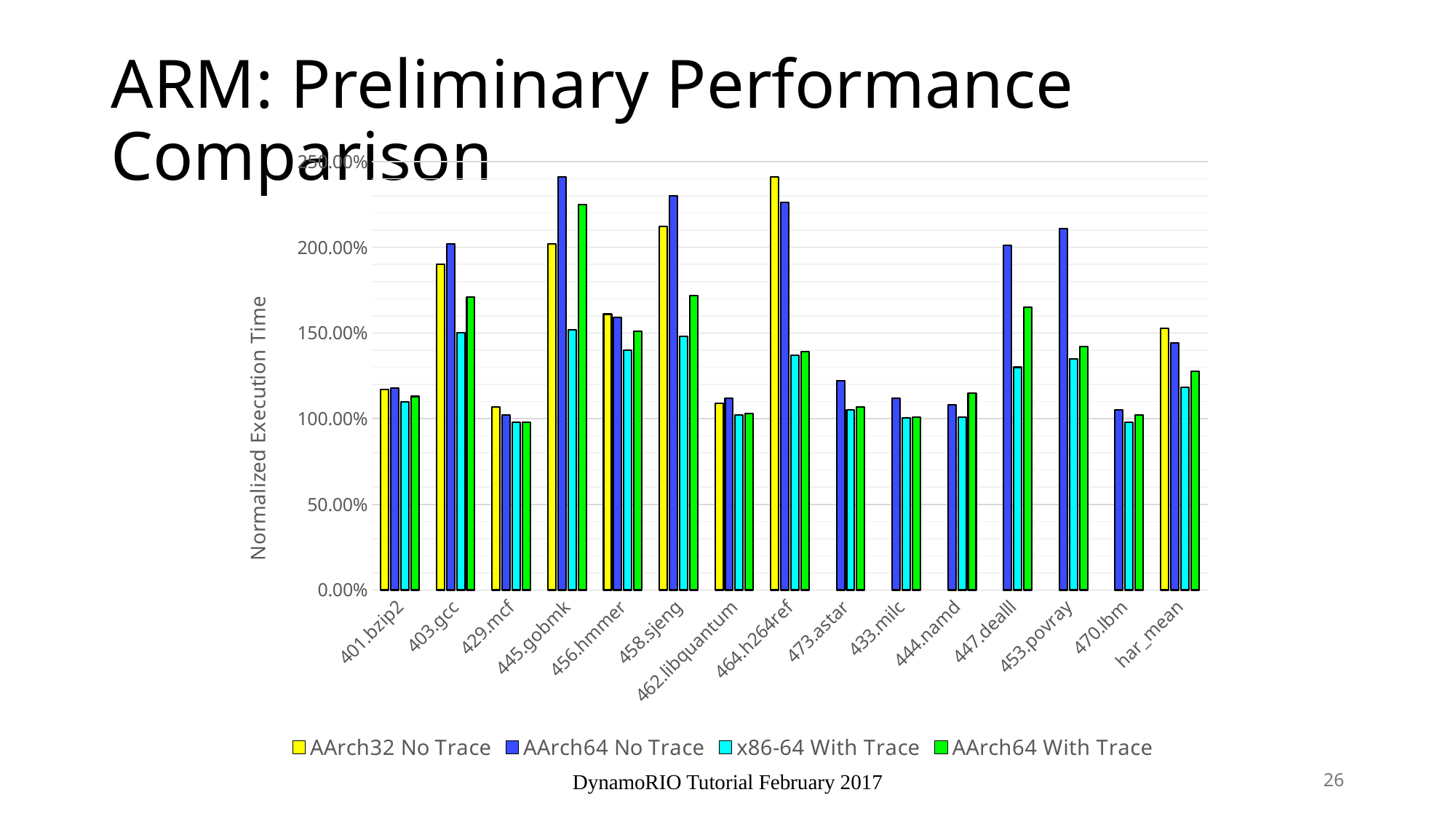
Which benchmark has the highest AArch32 No Trace value? 464.h264ref Is the x86-64 With Trace value for 447.dealII greater or less than 150.00%? less Is the AArch64 No Trace value for 445.gobmk greater or less than 200.00%? greater Is the AArch64 With Trace value for 447.dealII greater or less than 150.00%? greater Which benchmark has the highest AArch64 No Trace value? 445.gobmk What kind of chart is shown on the slide? bar chart For 447.dealII, which is larger: the AArch64 No Trace value or the AArch64 With Trace value? AArch64 No Trace What is the label of the vertical axis? Normalized Execution Time How many benchmark categories are shown along the x axis? 15 Which colour represents the AArch32 No Trace series in the legend? yellow How many series does the legend list? 4